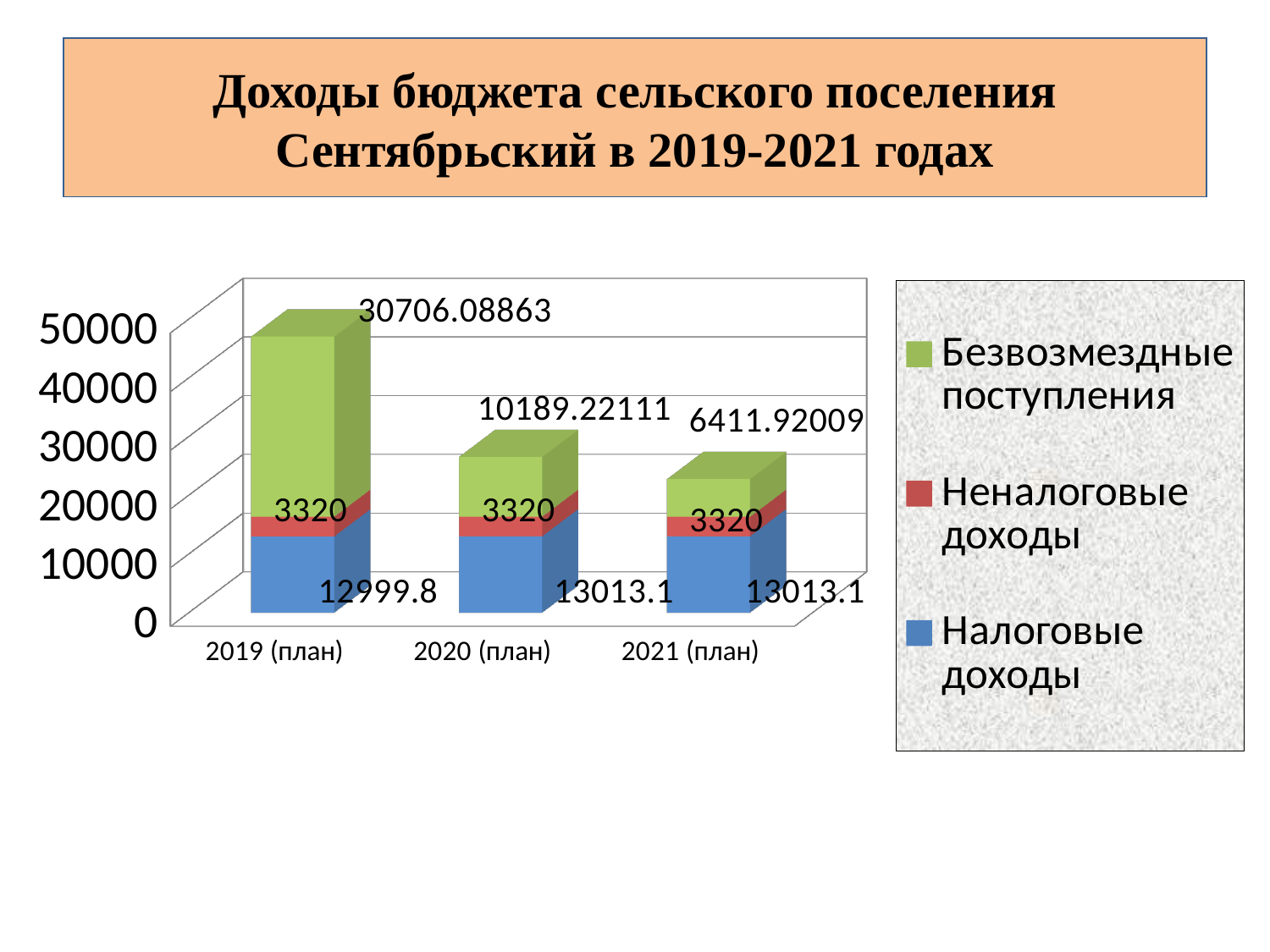
What is the total of the stacked bar for 2021 (план)? 22745.02009 What is the difference between Безвозмездные поступления in 2019 (план) and 2020 (план)? 20516.86752 Which is larger: Безвозмездные поступления in 2020 (план) or in 2021 (план)? 2020 (план) How many series does the legend list? 3 Which year has the lowest value of Безвозмездные поступления? 2021 (план) Which year has the highest value of Безвозмездные поступления? 2019 (план) How many categories are shown on the x axis? 3 What kind of chart is shown on the slide? Stacked bar chart What is the value of Налоговые доходы for 2021 (план)? 13013.1 What is the value of Неналоговые доходы for 2020 (план)? 3320 What is the value of Безвозмездные поступления for 2019 (план)? 30706.08863 What is the difference between Налоговые доходы in 2020 (план) and 2019 (план)? 13.3